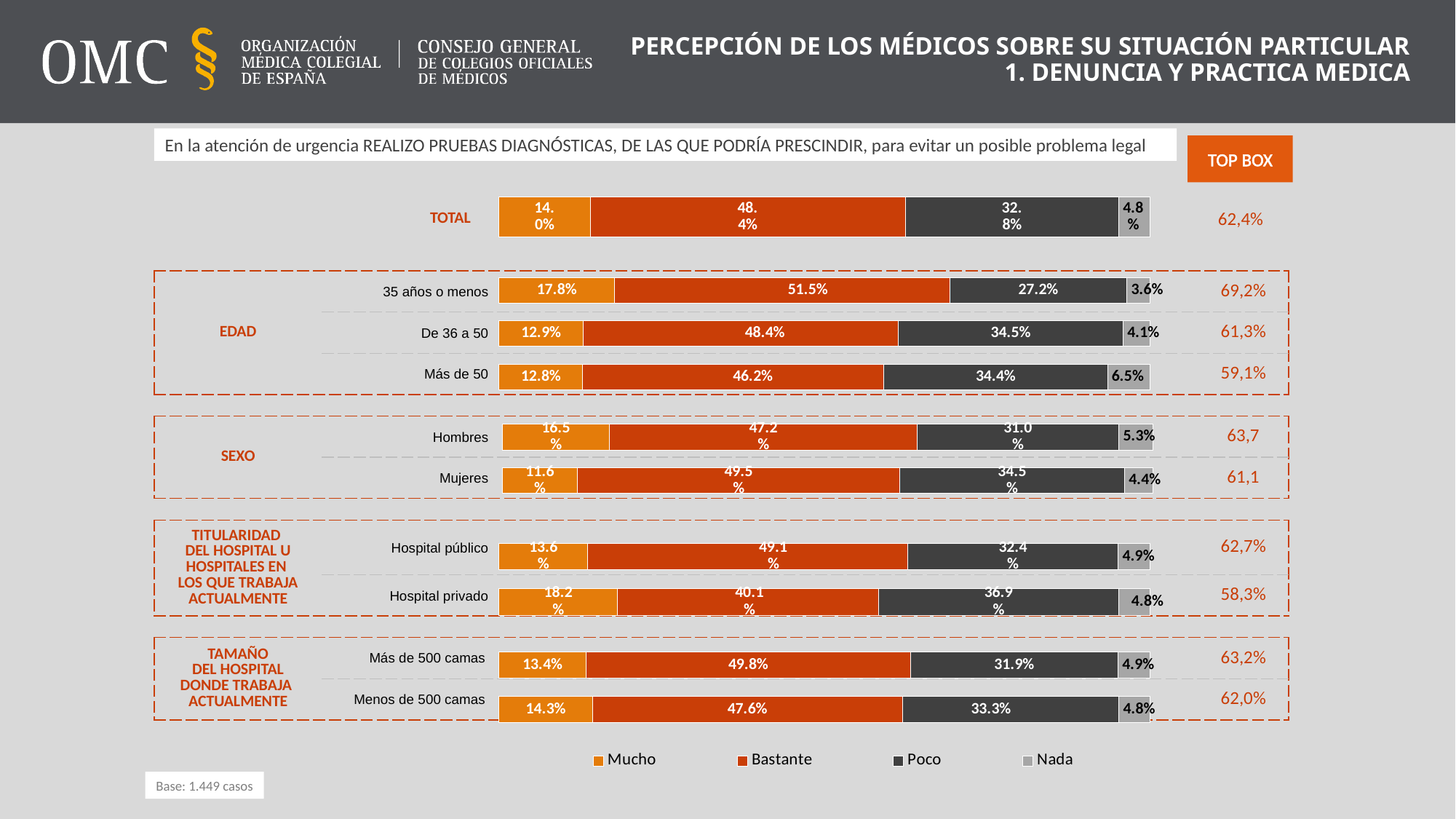
What is the "Mucho" value for "Hospital privado"? 18.2% How many category bars are plotted in the chart? 10 How many series does the legend list? 4 What kind of chart is shown on the slide? Stacked bar chart What is the "Bastante" value for the "35 años o menos" category? 51.5% What is the difference between the "Mucho" values for "Hombres" and "Mujeres"? 4.9% What is the "Poco" value for "Menos de 500 camas"? 33.3% Which category has the highest "Bastante" value? 35 años o menos Which category has the lowest "Mucho" value? Mujeres What is the "Nada" value for "Más de 50"? 6.5% What is the TOP BOX value shown for "De 36 a 50"? 61,3% Which is larger, the "Poco" value for "Hospital público" or for "Hospital privado"? Hospital privado